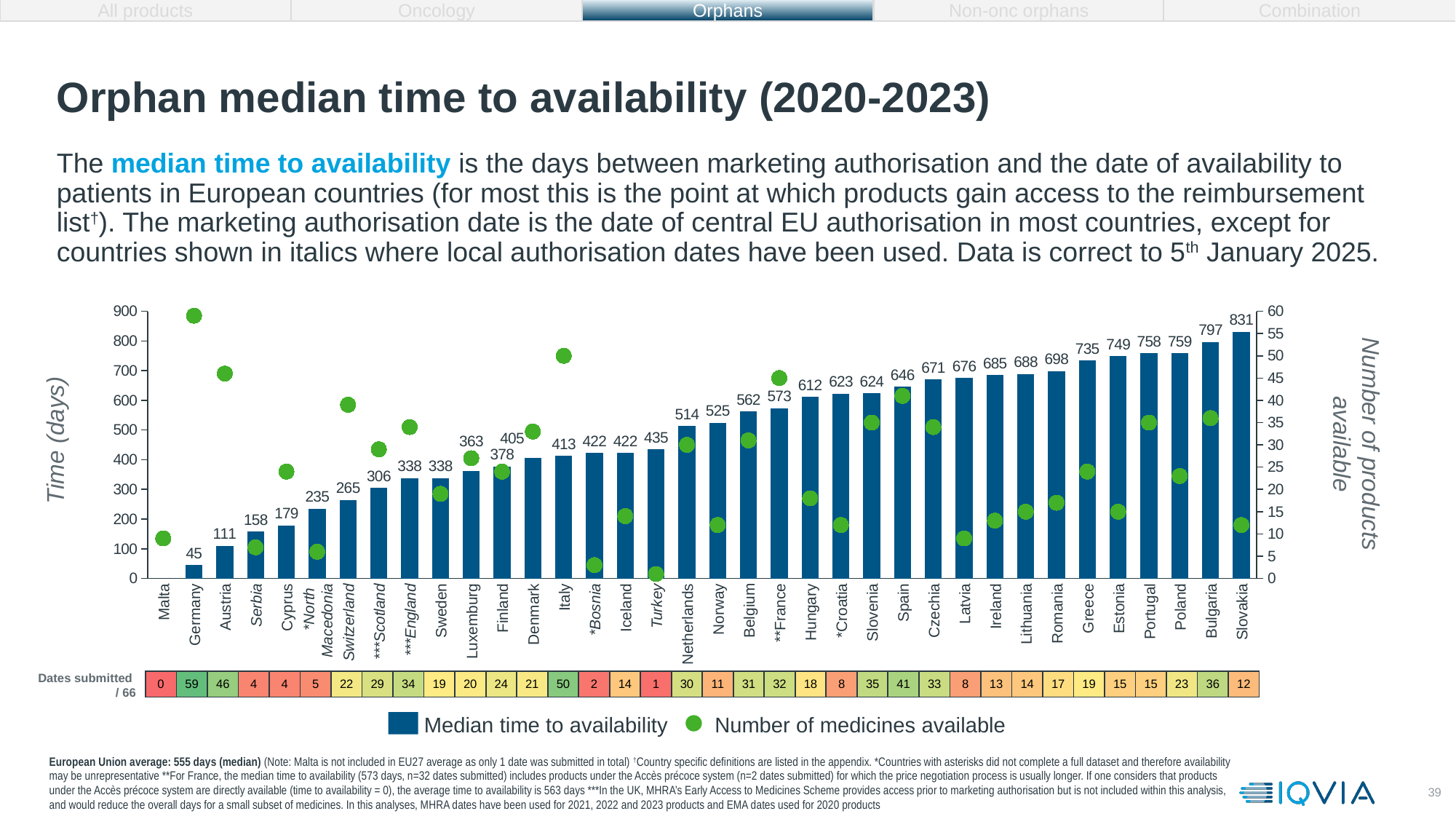
Which country has the highest median time to availability? Slovakia What is the difference in median time to availability between Bulgaria and Poland? 38 What is the difference in median time to availability between Slovakia and Germany? 786 Is the number of medicines available for Germany greater or less than 55? greater Do the median time to availability bars rise or fall from left to right across the chart? rise What is the median time to availability for **France? 573 Which has a longer median time to availability, Greece or Spain? Greece How many countries are shown on the x axis of the chart? 36 What is the median time to availability for Slovakia? 831 What is the median time to availability for Germany? 45 How many series does the chart legend list? 2 Is the number of medicines available for *Turkey greater or less than 5? less